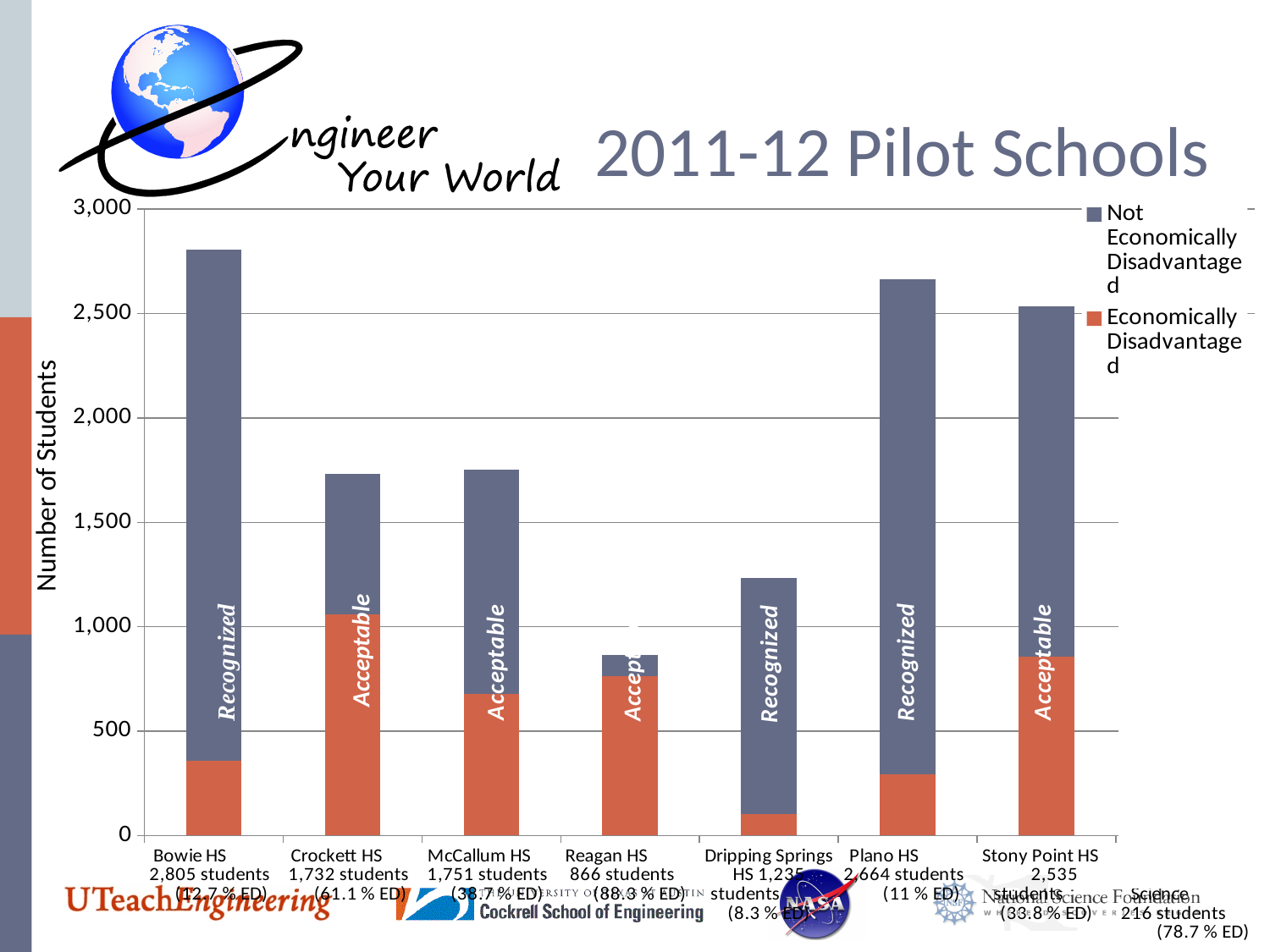
How many series does the legend list? 2 What percentage of students at Reagan HS are economically disadvantaged, according to the category label? 88.3 % ED How many students does the label for Bowie HS give? 2,805 students Is the total bar for Reagan HS greater or less than 1,000? less What is the difference in total students between Bowie HS (2,805) and Plano HS (2,664)? 141 Is the total bar for Dripping Springs HS greater or less than 1,000? greater What kind of chart is shown on the slide? stacked bar chart What is the label on the vertical axis? Number of Students Which school has the tallest bar (the most students)? Bowie HS What rating word is printed on the Crockett HS bar? Acceptable Which school has more students in total, Plano HS or Stony Point HS? Plano HS